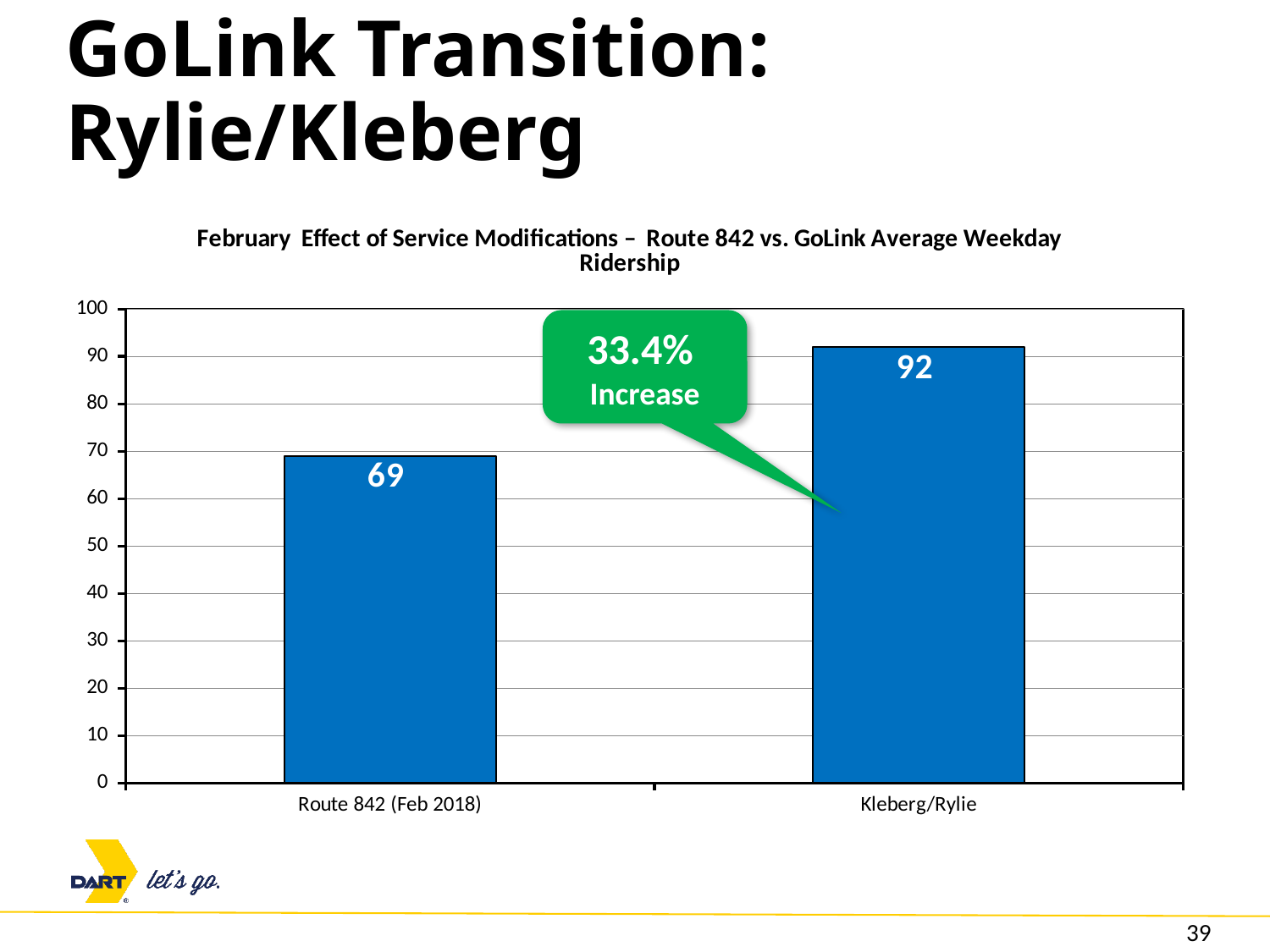
What is the average weekday ridership value shown for Route 842 (Feb 2018)? 69 How many categories are plotted on the chart? 2 What percentage increase does the callout on the chart state? 33.4% Do the values rise or fall from Route 842 (Feb 2018) to Kleberg/Rylie? Rise What kind of chart is shown on the slide? Bar chart What is the average weekday ridership value shown for Kleberg/Rylie? 92 Is the value for Kleberg/Rylie greater or less than 90? greater Which category has the higher value, Route 842 (Feb 2018) or Kleberg/Rylie? Kleberg/Rylie Which category has the lowest value on the chart? Route 842 (Feb 2018) Is the value for Route 842 (Feb 2018) greater or less than 70? less What is the maximum value shown on the vertical axis of the chart? 100 What is the difference between the Kleberg/Rylie value and the Route 842 (Feb 2018) value? 23